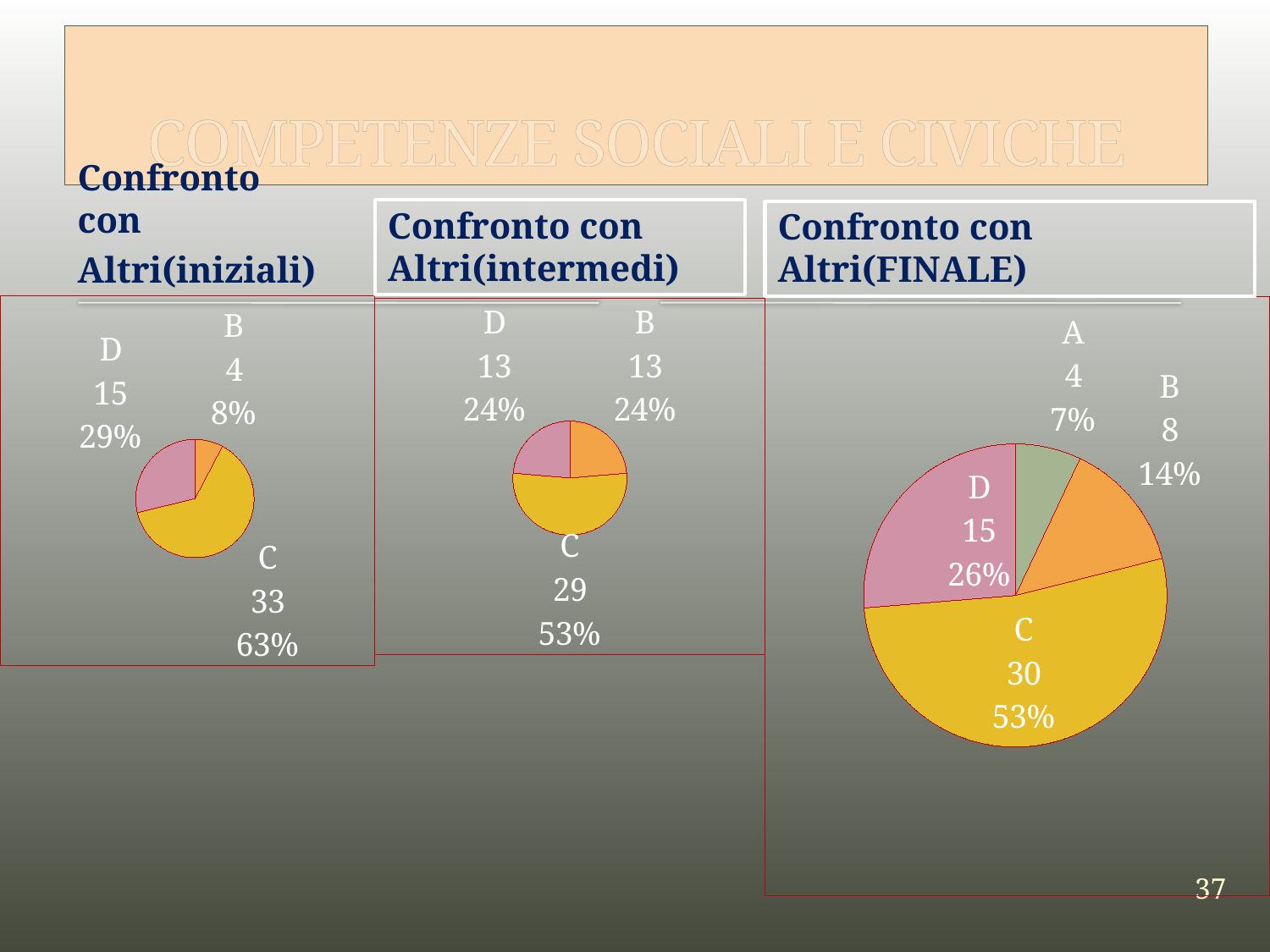
In the 'Confronto con Altri(FINALE)' chart, what is the difference between the values for D and B? 7 In the 'Confronto con Altri(FINALE)' chart, what share of the pie does A represent? 7% How many slices does the 'Confronto con Altri(intermedi)' pie chart have? 3 In the 'Confronto con Altri(FINALE)' chart, which category has the largest slice? C What type of chart is used in the 'Confronto con Altri(FINALE)' panel? Pie chart In the 'Confronto con Altri(intermedi)' chart, what is the value for C? 29 In the 'Confronto con Altri(iniziali)' chart, what share of the pie does D represent? 29% In the 'Confronto con Altri(FINALE)' chart, which is larger, the value for D or the value for B? D In the 'Confronto con Altri(intermedi)' chart, what share of the pie does B represent? 24% In the 'Confronto con Altri(FINALE)' chart, what is the value for B? 8 In the 'Confronto con Altri(iniziali)' chart, what is the value for C? 33 In the 'Confronto con Altri(iniziali)' chart, which category has the smallest slice? B